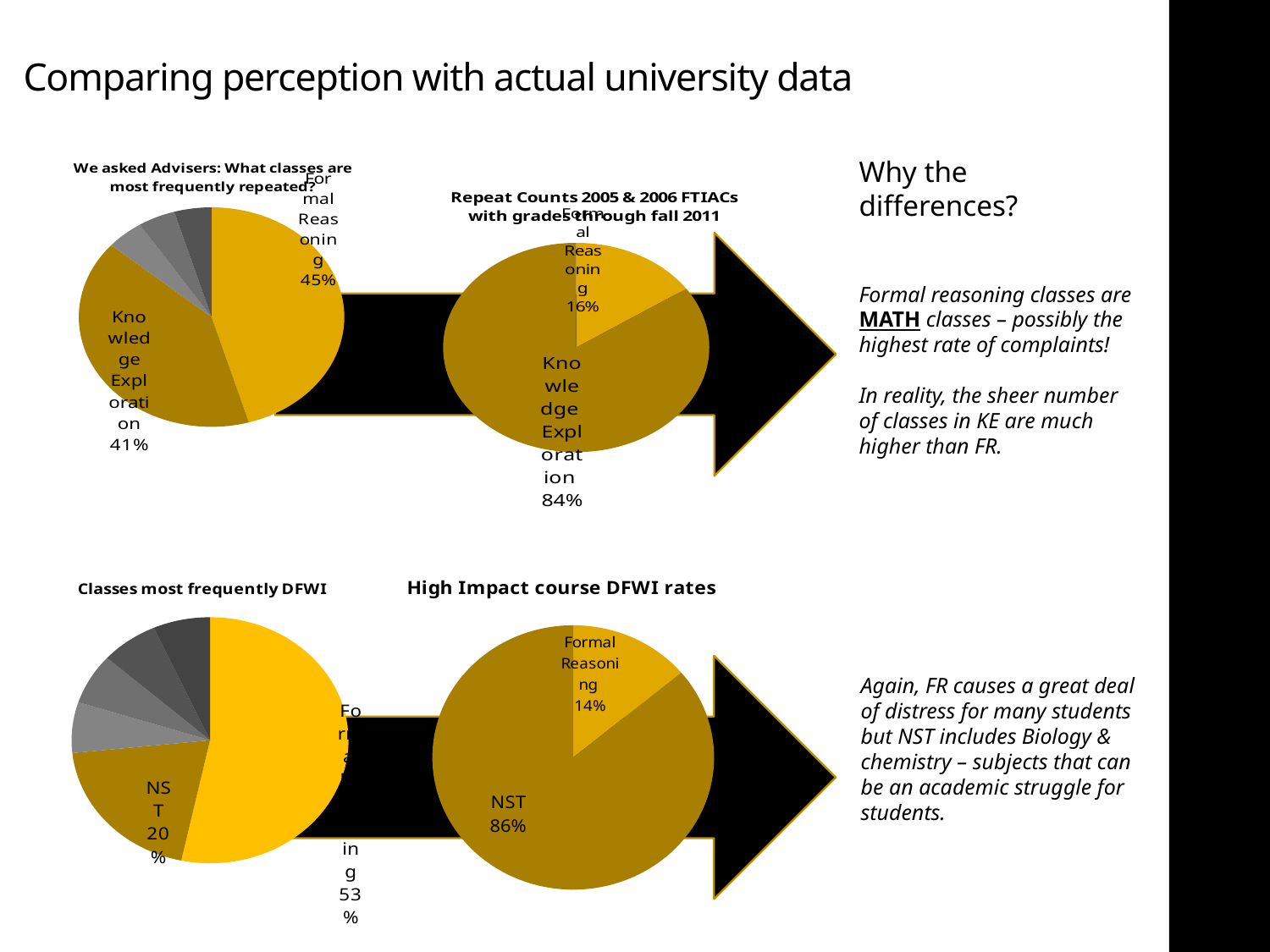
In the 'Classes most frequently DFWI' pie chart, what percentage is shown for NST? 20% In the 'We asked Advisers: What classes are most frequently repeated?' pie chart, what percentage is shown for Formal Reasoning? 45% In the 'High Impact course DFWI rates' pie chart, what share is NST? 86% In the 'We asked Advisers: What classes are most frequently repeated?' pie chart, what percentage is shown for Knowledge Exploration? 41% In the 'Repeat Counts 2005 & 2006 FTIACs with grades through fall 2011' pie chart, what share is Formal Reasoning? 16% In the 'Repeat Counts 2005 & 2006 FTIACs with grades through fall 2011' pie chart, what share is Knowledge Exploration? 84% In the 'Repeat Counts 2005 & 2006 FTIACs with grades through fall 2011' pie chart, what is the difference between the Knowledge Exploration and Formal Reasoning shares? 68% In the 'High Impact course DFWI rates' pie chart, which slice is the largest? NST What type of chart is 'High Impact course DFWI rates'? Pie chart In the 'High Impact course DFWI rates' pie chart, what is the difference between the NST and Formal Reasoning shares? 72% In the 'Repeat Counts 2005 & 2006 FTIACs with grades through fall 2011' pie chart, which slice is the smallest? Formal Reasoning